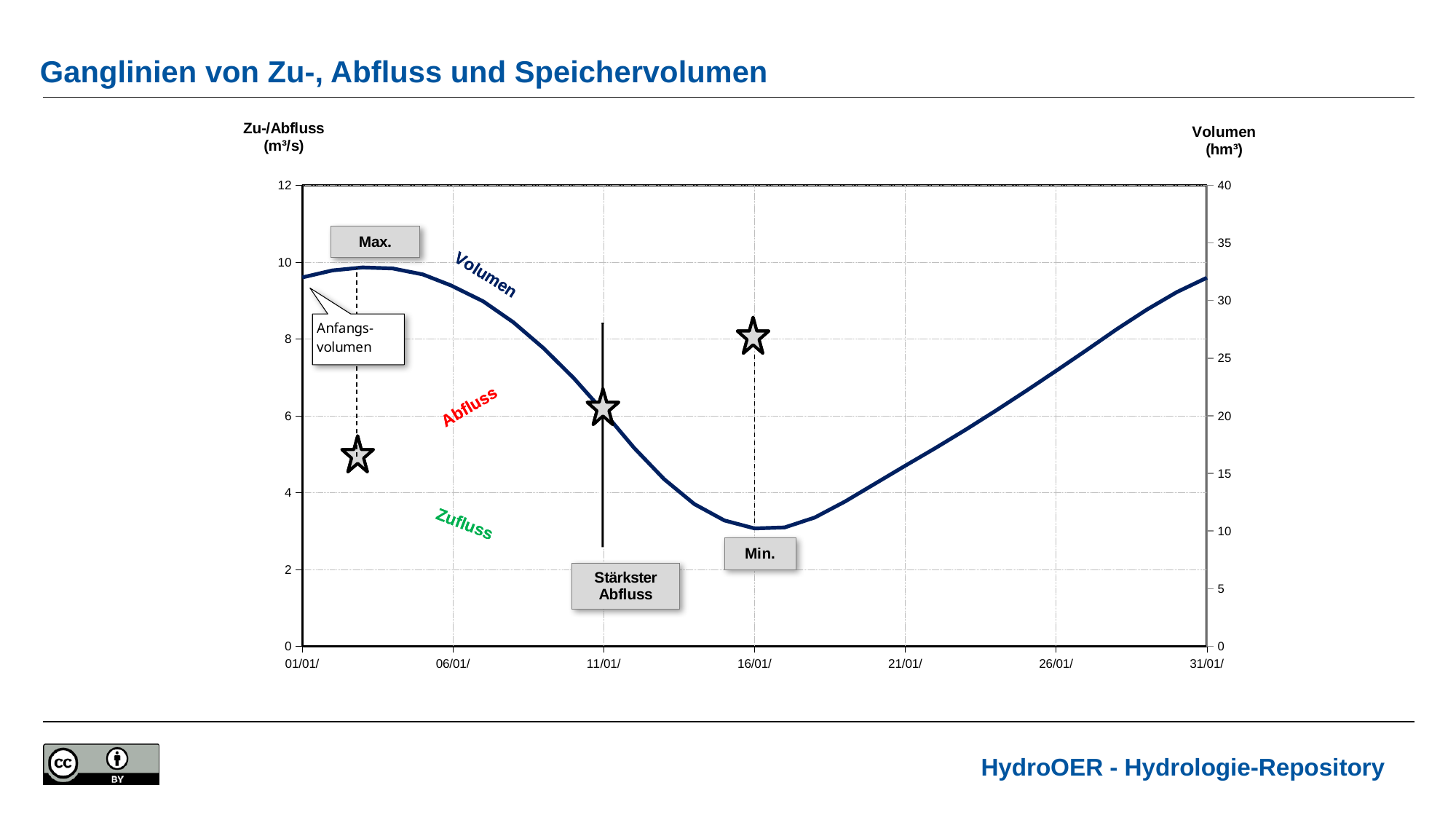
Does the Volumen curve rise or fall between 16/01/ and 31/01/? rise Is the Volumen value at 21/01/ greater or less than 15 hm³? greater Does the Volumen curve rise or fall between 01/01/ and 16/01/? fall What is the title of the slide's chart? Ganglinien von Zu-, Abfluss und Speichervolumen What kind of chart is shown on the slide? line chart Which is larger, the Volumen value at 01/01/ or at 16/01/? 01/01/ Near which date on the x axis is the Volumen curve at its minimum (marked Min.)? 16/01/ What unit is shown on the right-hand axis labelled Volumen? hm³ Is the Volumen value at 26/01/ greater or less than 20 hm³? greater Is the maximum of the Volumen curve (marked Max.) greater or less than 35 hm³? less How many date labels are shown on the x axis? 7